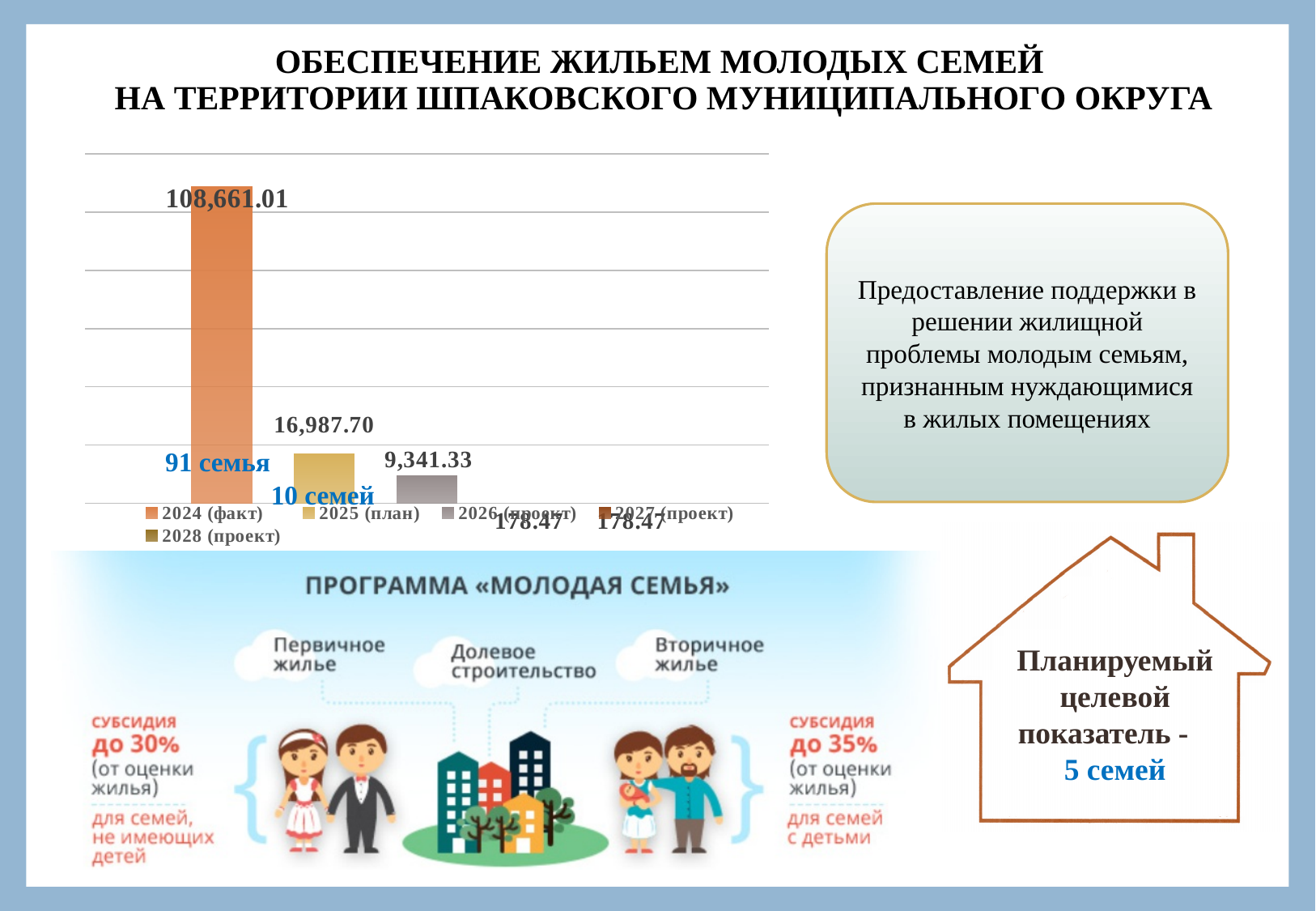
Which is larger, the value for 2025 (план) or the value for 2026 (проект)? 2025 (план) What is the difference between the values for 2025 (план) and 2026 (проект)? 7,646.37 What is the value shown for 2027 (проект)? 178.47 What is the value shown for 2025 (план)? 16,987.70 What kind of chart is shown on the slide? bar chart How many series does the legend list? 5 What is the value shown for 2026 (проект)? 9,341.33 Do the values rise or fall from 2024 to 2026? fall How many families are annotated next to the 2024 (факт) bar? 91 семья What is the difference between the values for 2024 (факт) and 2025 (план)? 91,673.31 Which series has the highest value in the chart? 2024 (факт) What is the value shown for 2024 (факт)? 108,661.01